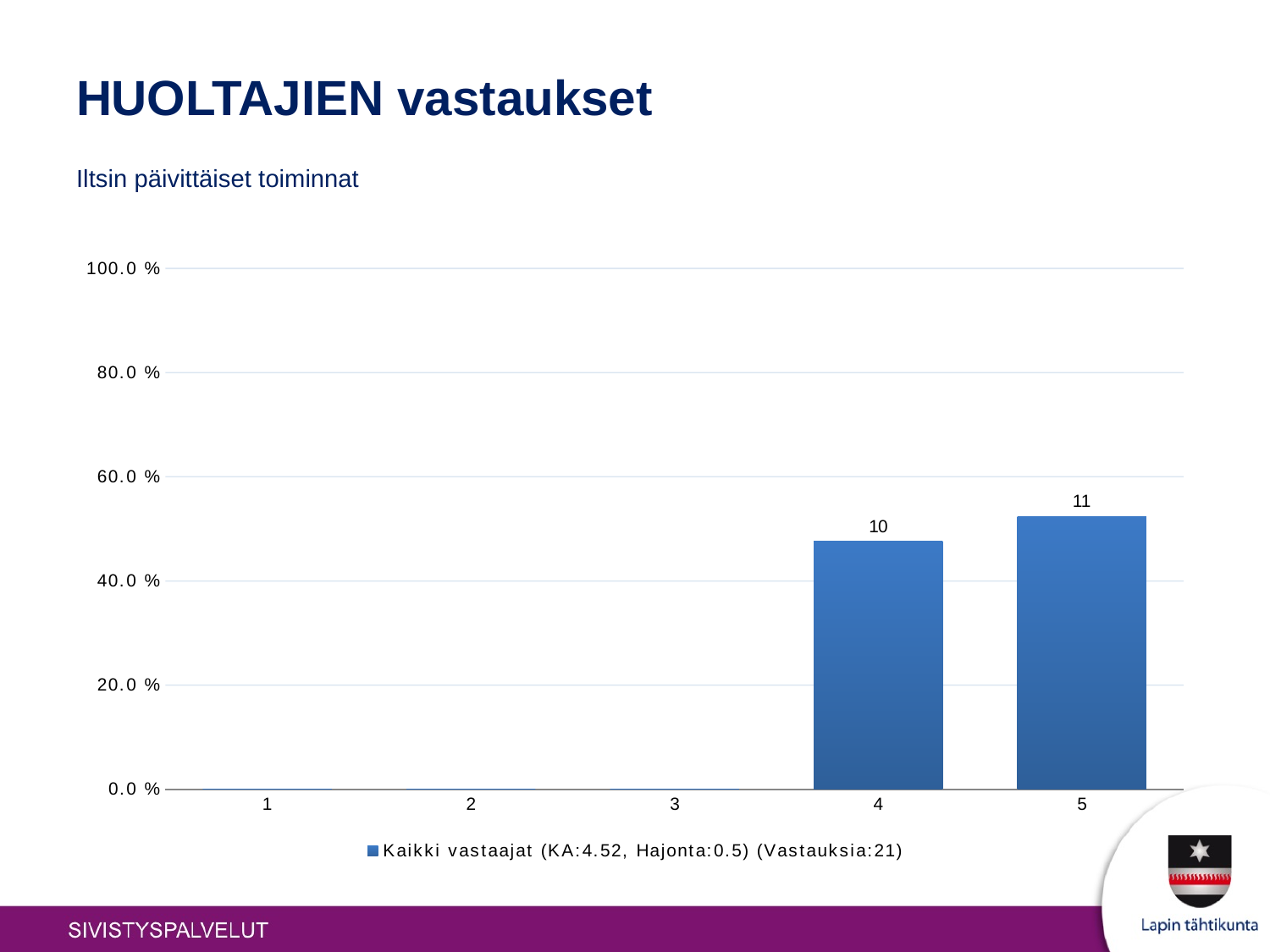
What is the difference between the data labels for categories 5 and 4? 1 How many categories are shown on the x axis? 5 Which bar is taller, category 4 or category 5? 5 Is the value for category 4 greater or less than 40.0 %? greater How many series does the legend list? 1 Is the value for category 5 greater or less than 60.0 %? less What is the data label shown on the bar for category 5? 11 What kind of chart is shown on the slide? bar chart What is the data label shown on the bar for category 4? 10 What is the legend entry for the series shown in the chart? Kaikki vastaajat (KA:4.52, Hajonta:0.5) (Vastauksia:21) Is the value for category 2 greater or less than 20.0 %? less Which category has the highest bar? 5